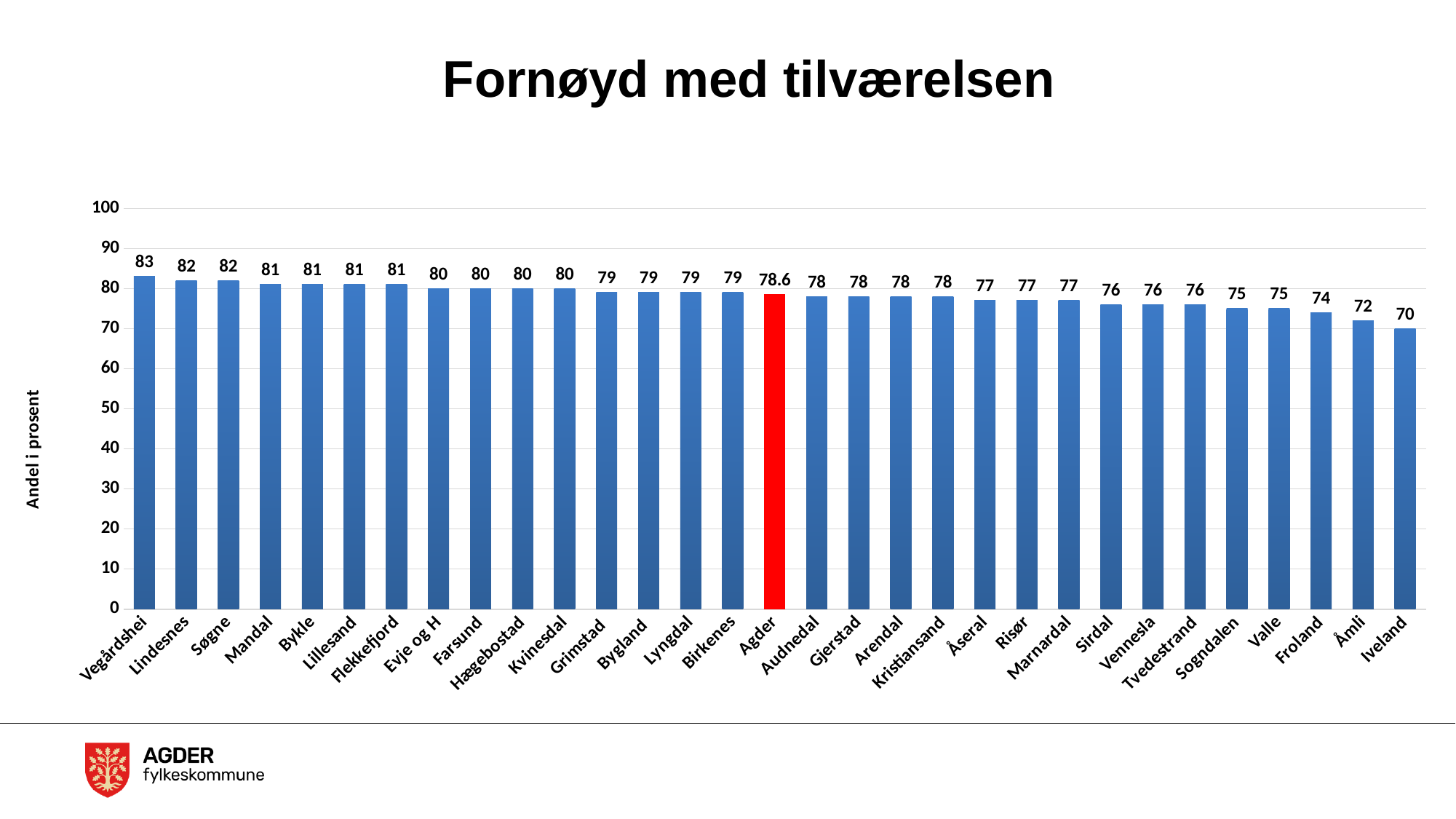
What is the value for Agder? 78.6 Which is larger, the value for Søgne or the value for Froland? Søgne What is the value for Iveland? 70 Which category has the highest value? Vegårdshei What is the value for Vegårdshei? 83 What is the difference between the values for Vegårdshei and Iveland? 13 What kind of chart is this? Bar chart What is the value for Kristiansand? 78 Which bar is coloured red? Agder Which category has the lowest value? Iveland How many categories are shown on the x axis? 31 Do the values rise or fall from left to right along the x axis? Fall